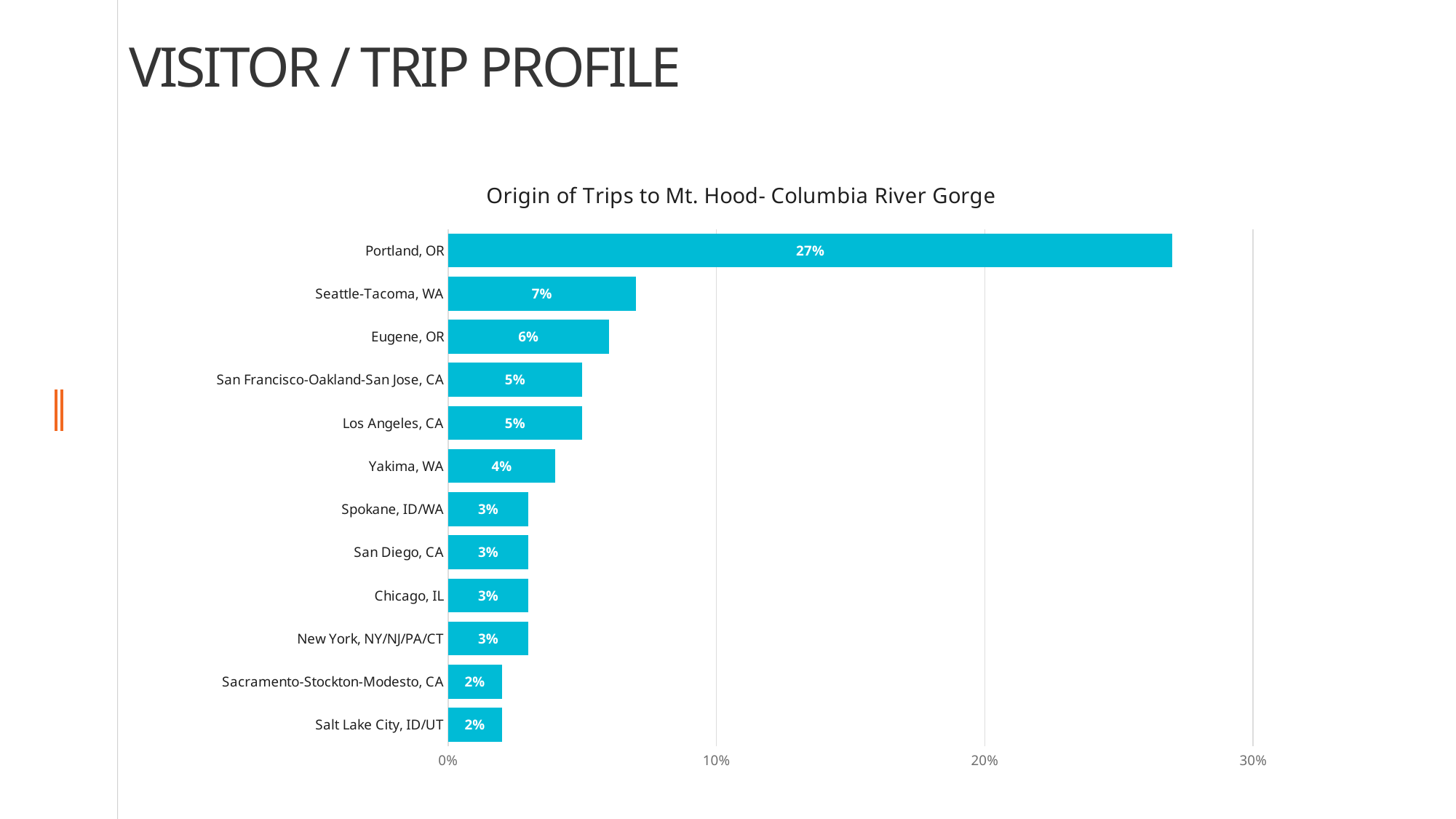
What is the value shown for Salt Lake City, ID/UT? 2% Is the value for Portland, OR greater or less than 20%? greater Which origin has the highest share of trips? Portland, OR What is the difference between the values for Portland, OR and Seattle-Tacoma, WA? 20% What percentage of trips to Mt. Hood-Columbia River Gorge originate from Portland, OR? 27% What kind of chart is shown on the slide? Bar chart What is the title of the chart? Origin of Trips to Mt. Hood- Columbia River Gorge Which is larger, the value for Eugene, OR or the value for Los Angeles, CA? Eugene, OR What is the value shown for Seattle-Tacoma, WA? 7% How many origin categories are shown in the chart? 12 What is the value shown for Yakima, WA? 4% What is the difference between the values for Eugene, OR and Yakima, WA? 2%